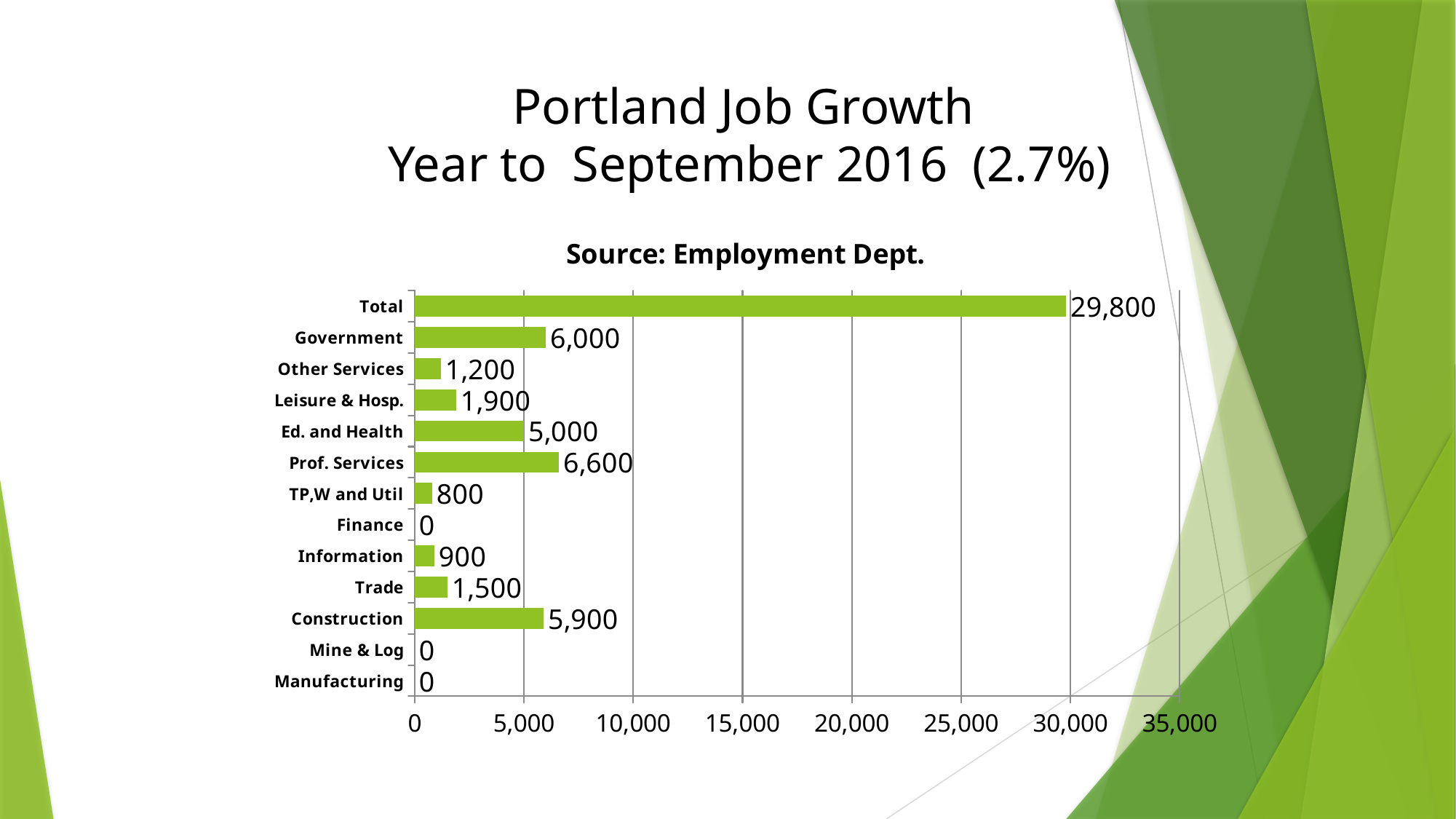
Excluding Total, which category has the highest value? Prof. Services What is the value for Government? 6,000 What is the value for Prof. Services? 6,600 What is the value for Construction? 5,900 What is the difference between Ed. and Health and Leisure & Hosp.? 3,100 What is the value for Total? 29,800 What kind of chart is shown? Bar chart What is the chart's title? Source: Employment Dept. Which is larger, Trade or Other Services? Trade Is the value for Total greater or less than 25,000? greater What is the difference between Prof. Services and Government? 600 How many categories are shown on the chart? 13